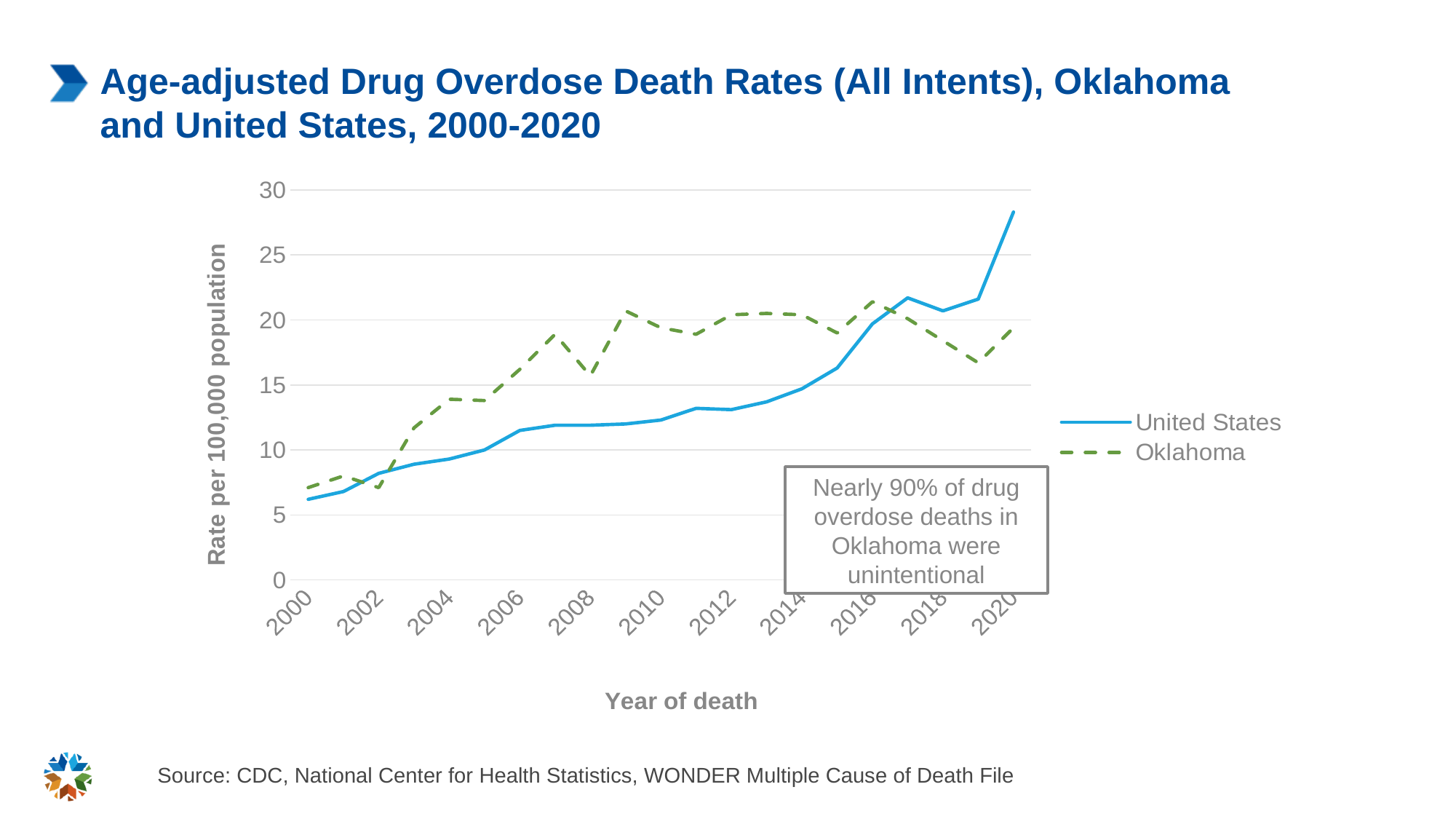
In 2012, which series has the higher value, United States or Oklahoma? Oklahoma Is the Oklahoma value for 2019 greater or less than 20? less Does the United States series generally rise or fall from 2000 to 2020? Rise What is the label of the y axis? Rate per 100,000 population What kind of chart is shown on the slide? Line chart Which two series are listed in the legend? United States and Oklahoma In which year does the United States series reach its highest value? 2020 Is the United States value for 2000 greater or less than 10? less How many series does the legend list? 2 Is the United States value for 2020 greater or less than 25? greater In 2020, which series has the higher value, United States or Oklahoma? United States